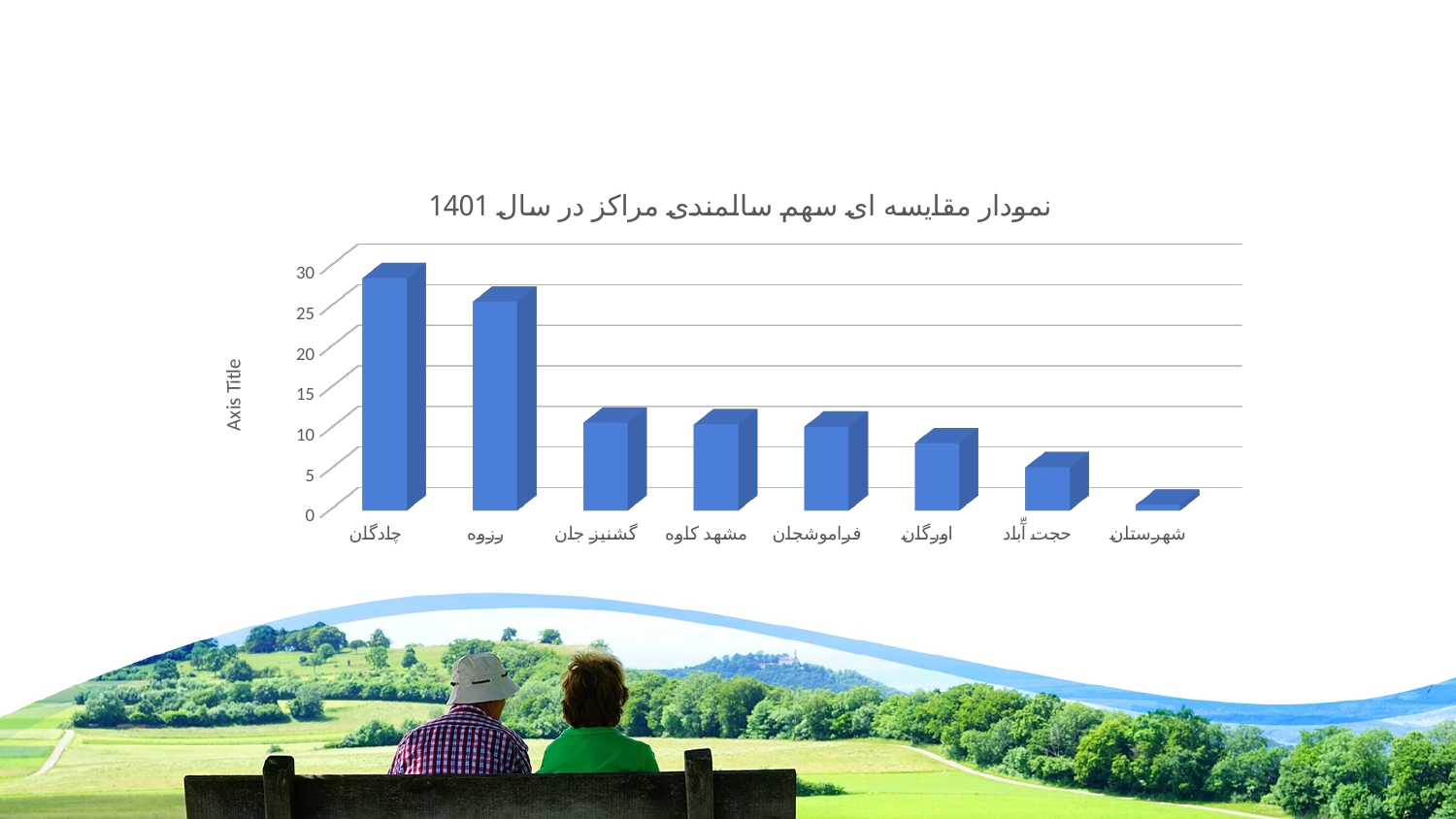
Which category has the highest value in the chart? چادگان How many categories are shown on the x axis of the chart? 8 What is the title of the chart? نمودار مقایسه ای سهم سالمندی مراکز در سال 1401 Is the value for حجت آباد greater or less than 10? less Is the value for چادگان greater or less than 25? greater Is the value for شهرستان greater or less than 5? less Which has a larger value, چادگان or حجت آباد? چادگان Do the values generally rise or fall moving from left to right along the x axis? fall What kind of chart is shown on the slide? bar chart Which category has the lowest value in the chart? شهرستان